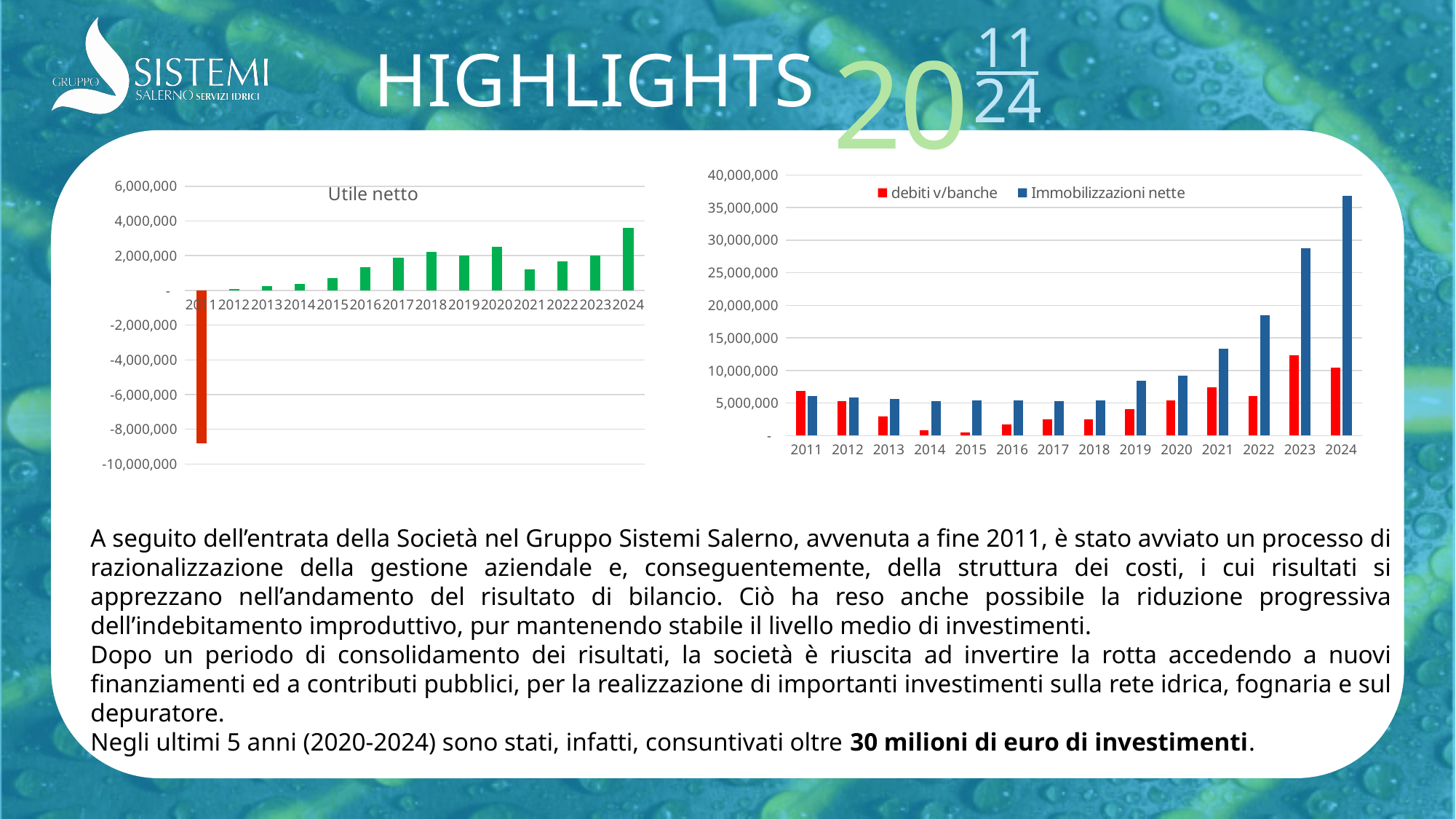
In the right-hand chart, is the value of debiti v/banche for 2023 greater or less than 10,000,000? greater In the 'Utile netto' chart, is the value for 2021 greater or less than 2,000,000? less What type of chart is the 'Utile netto' chart on the left? bar chart In the 'Utile netto' chart, is the value for 2011 greater or less than -8,000,000? less In the 'Utile netto' chart, which year has the lowest value? 2011 In the 'Utile netto' chart, which year has the highest value? 2024 How many years are shown on the x axis of the 'Utile netto' chart? 14 In the right-hand chart, which series has the larger value in 2024, debiti v/banche or Immobilizzazioni nette? Immobilizzazioni nette In the right-hand chart, which year has the highest value for Immobilizzazioni nette? 2024 How many series does the legend of the right-hand chart list? 2